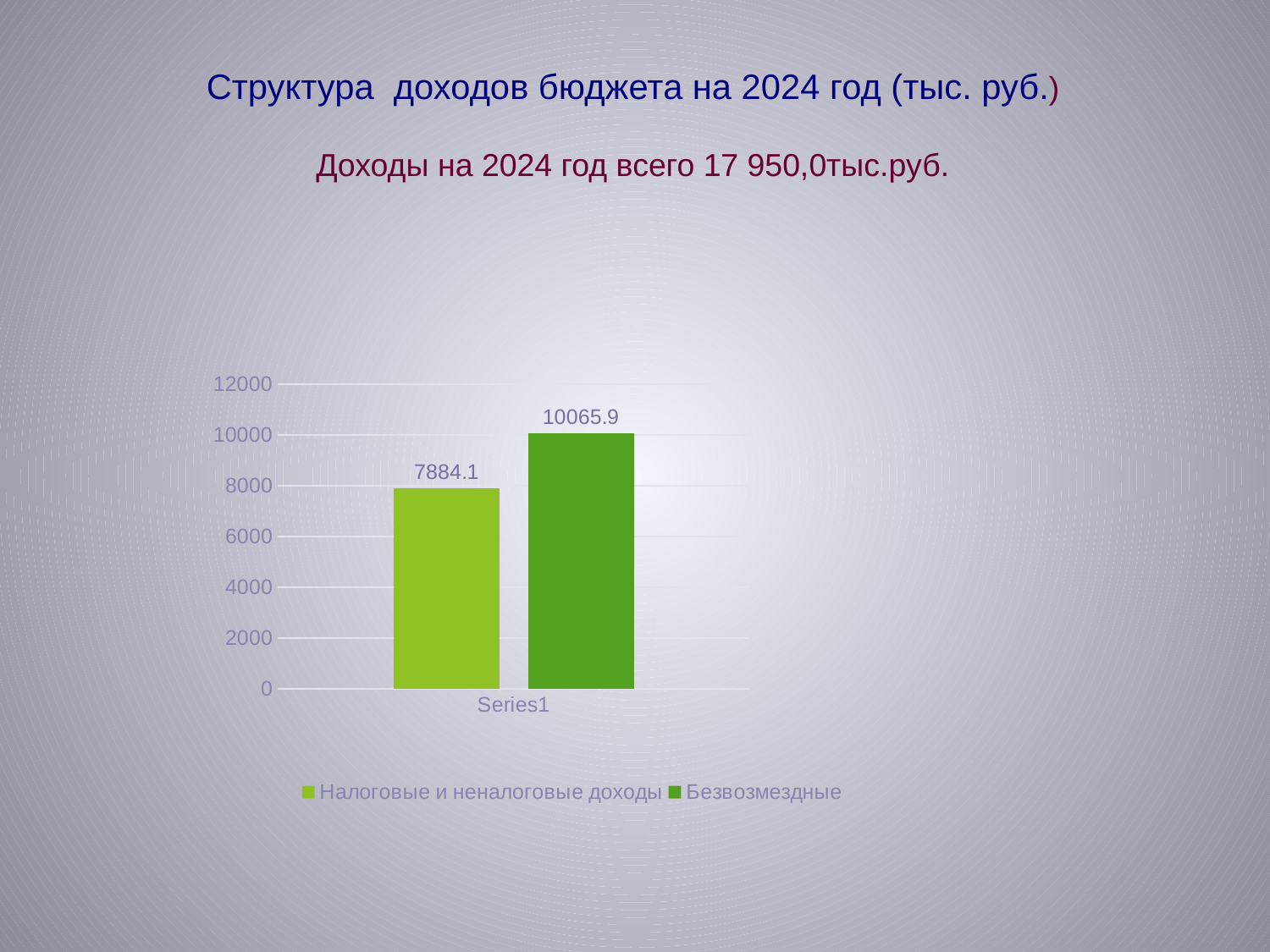
Which series has the higher value, Налоговые и неналоговые доходы or Безвозмездные? Безвозмездные What kind of chart is shown on the slide? bar chart What is the difference between the values for Безвозмездные and Налоговые и неналоговые доходы? 2181.8 Which series has the highest value? Безвозмездные What is the label shown on the category axis below the bars? Series1 What is the value for Безвозмездные? 10065.9 Is the value for Безвозмездные greater or less than 10000? greater Is the value for Налоговые и неналоговые доходы greater or less than 8000? less What is the highest value shown on the vertical axis? 12000 Which series has the lowest value? Налоговые и неналоговые доходы What is the value for Налоговые и неналоговые доходы? 7884.1 How many series does the legend list? 2